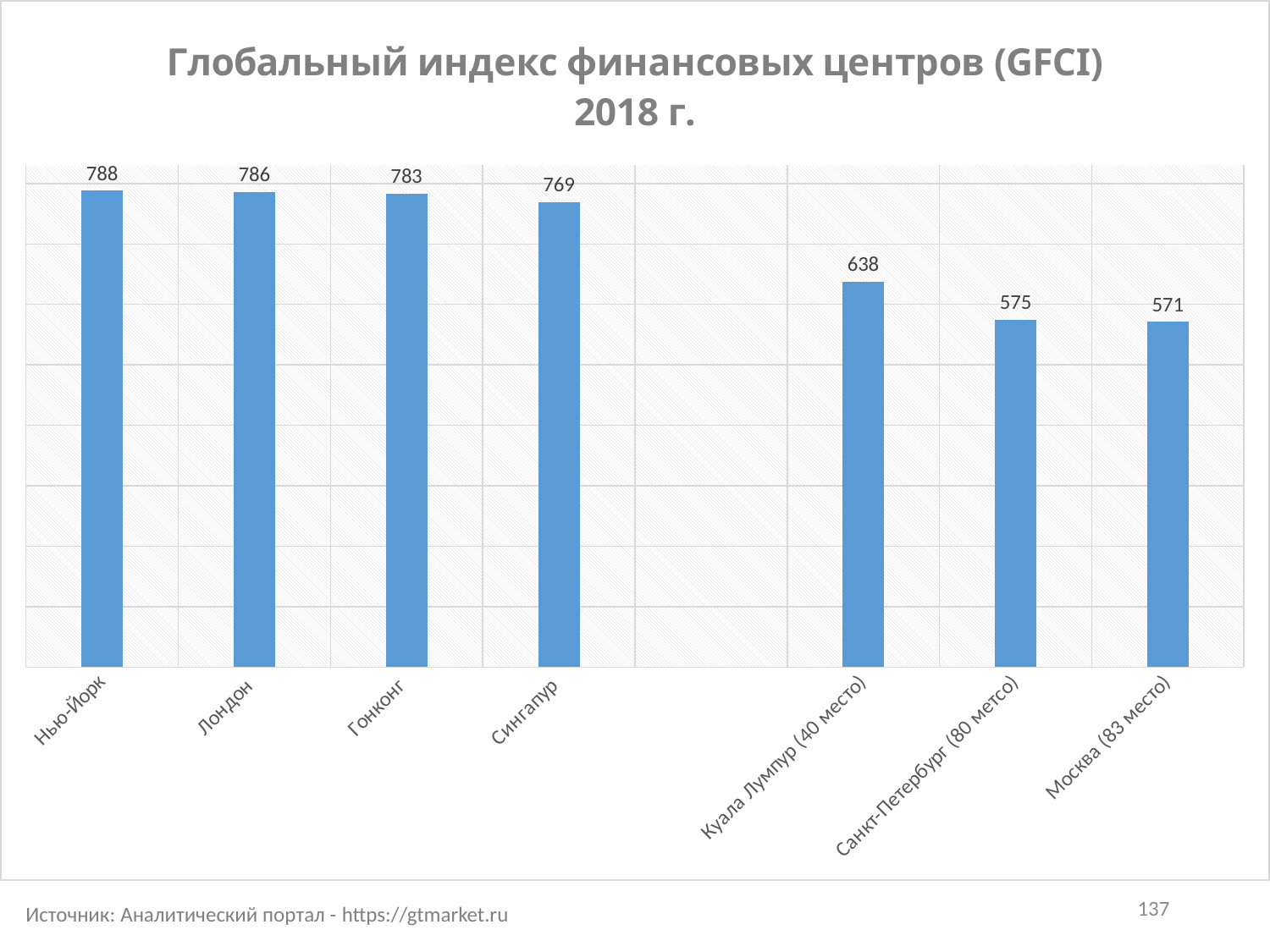
What is the value shown for Санкт-Петербург (80 метсо)? 575 What kind of chart is shown on the slide? Bar chart Which has a larger value, Гонконг or Куала Лумпур (40 место)? Гонконг What is the title of the chart? Глобальный индекс финансовых центров (GFCI) 2018 г. Which financial centre has the lowest GFCI value on the chart? Москва (83 место) What is the difference between the values for Сингапур and Куала Лумпур (40 место)? 131 What is the difference between the values for Нью-Йорк and Москва (83 место)? 217 How many financial centres are shown on the chart? 7 Which financial centre has the highest GFCI value on the chart? Нью-Йорк What is the GFCI value for Нью-Йорк? 788 What is the GFCI value for Сингапур? 769 What is the value shown for Москва (83 место)? 571